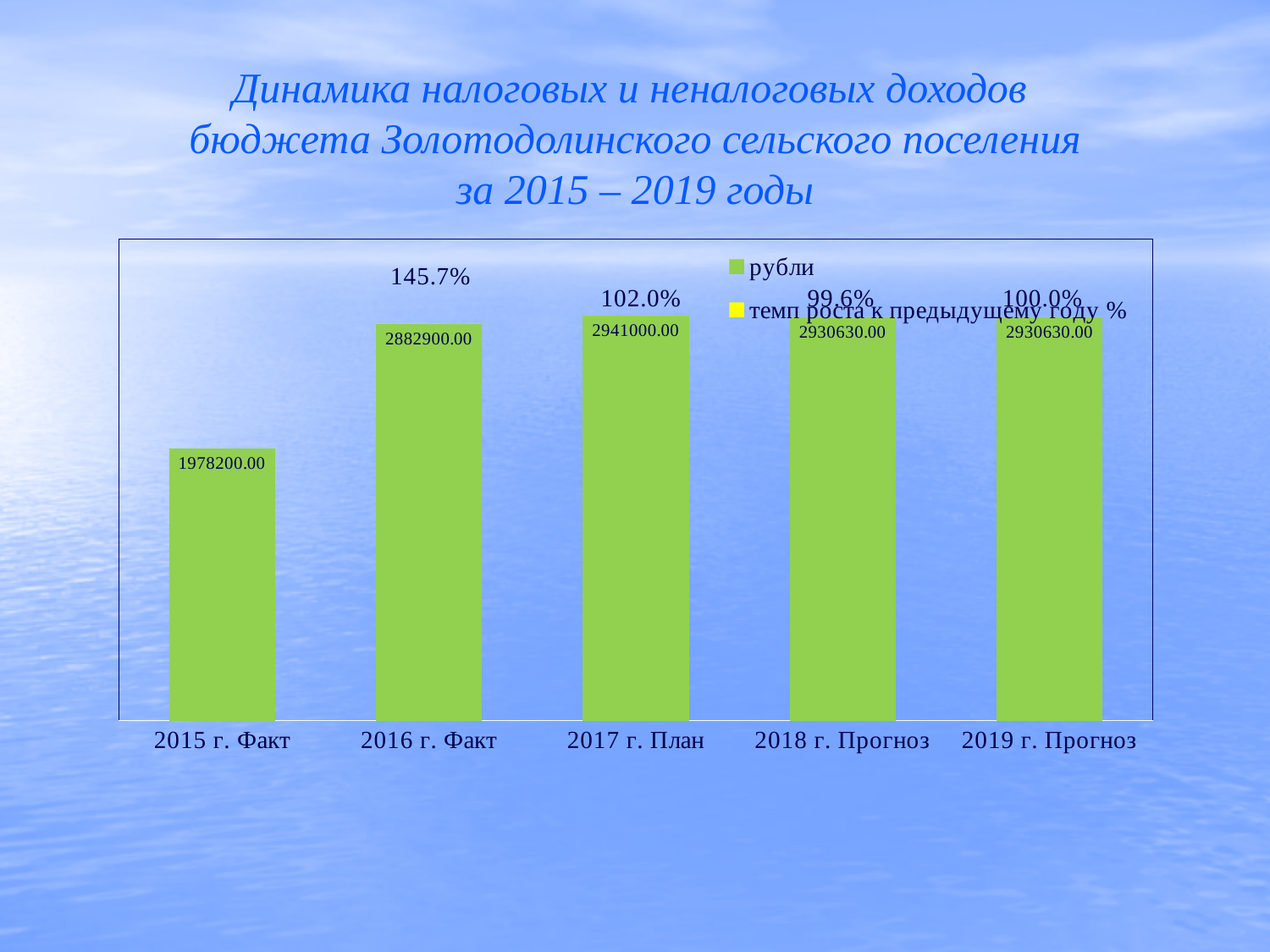
Which category has the highest value in rubles? 2017 г. План What is the growth rate to the previous year shown for 2018 г. Прогноз? 99.6% Which is larger, the value in rubles for 2017 г. План or for 2018 г. Прогноз? 2017 г. План Which category has the lowest value in rubles? 2015 г. Факт How many series does the legend list? 2 How many categories are shown on the x axis? 5 What is the difference in rubles between 2016 г. Факт and 2015 г. Факт? 904700.00 What is the growth rate to the previous year shown for 2016 г. Факт? 145.7% What is the value in rubles for 2017 г. План? 2941000.00 What is the value in rubles for 2015 г. Факт? 1978200.00 What is the second legend entry of the chart? темп роста к предыдущему году % What kind of chart is shown on the slide? Bar chart